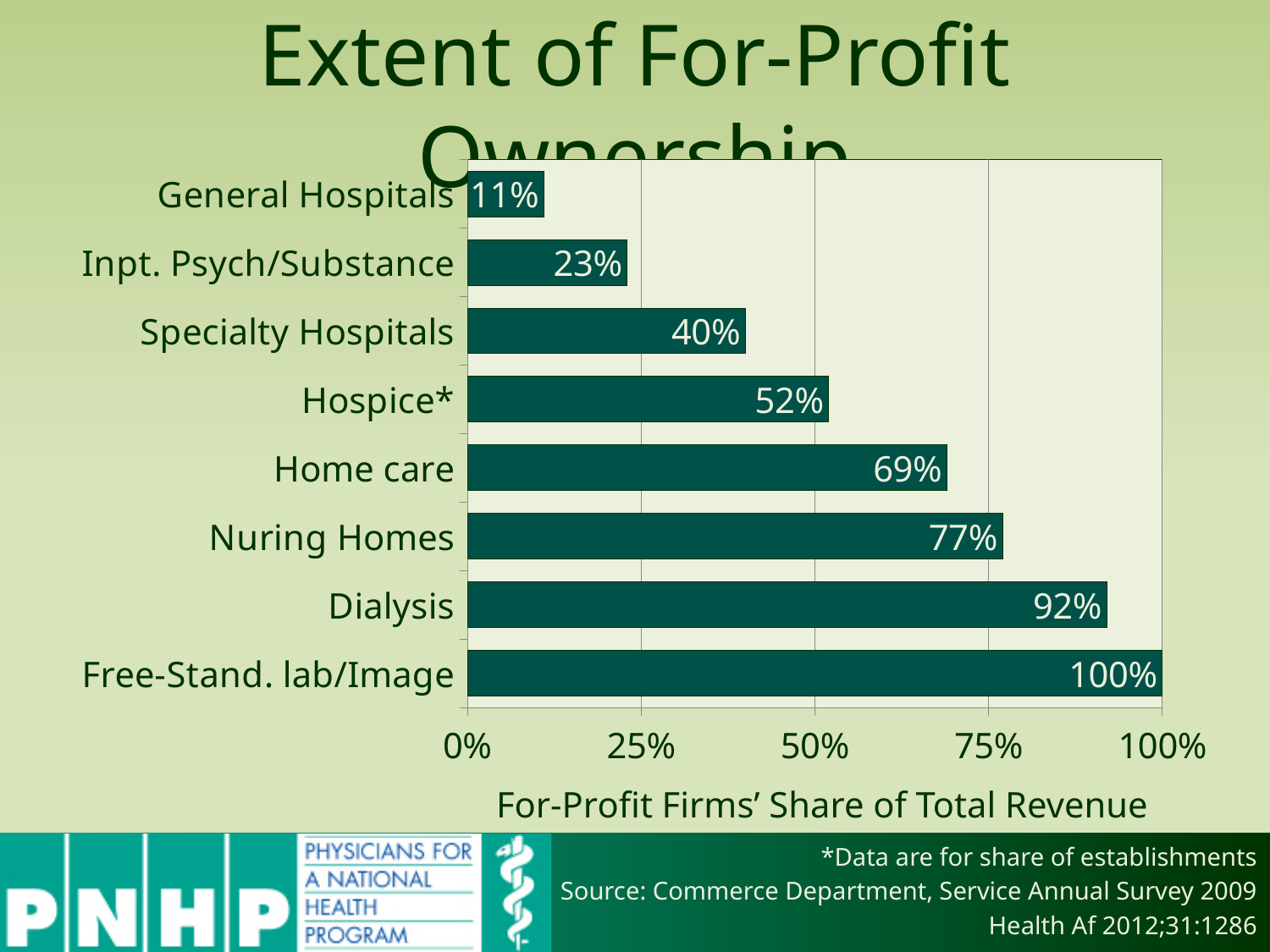
Is the value for Hospice* greater or less than 50%? greater How many categories are shown in the chart? 8 What value is shown for Specialty Hospitals? 40% What kind of chart is shown on the slide? Bar chart What is the for-profit firms' share of total revenue for Home care? 69% What is the difference between the values for Nuring Homes and Hospice*? 25% Which is larger, the value for Inpt. Psych/Substance or the value for Specialty Hospitals? Specialty Hospitals Which category has the highest for-profit share? Free-Stand. lab/Image Which category has the lowest for-profit share? General Hospitals What is the value for Dialysis? 92% What is the label of the horizontal axis? For-Profit Firms' Share of Total Revenue What is the difference between the values for Free-Stand. lab/Image and General Hospitals? 89%